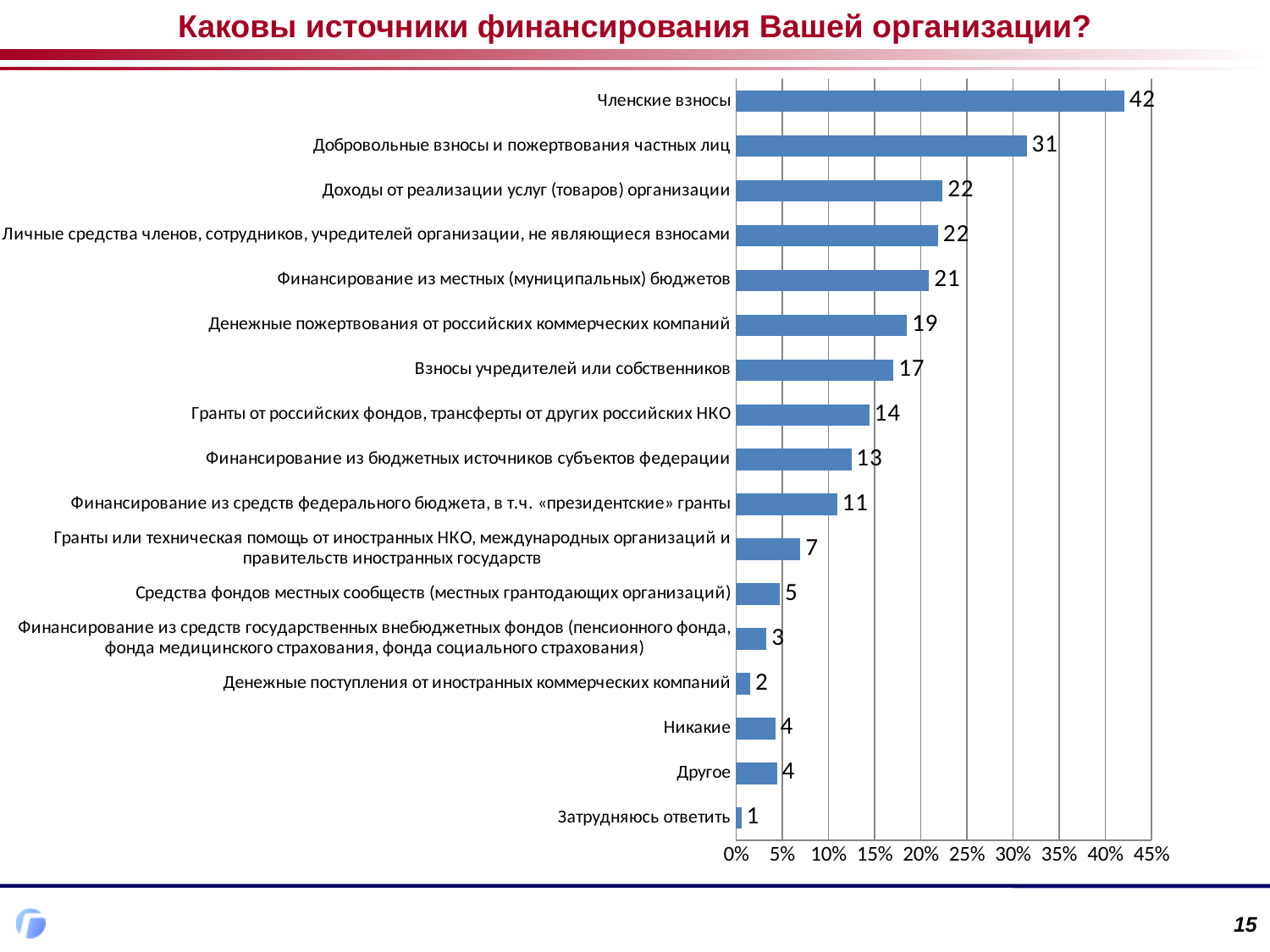
What is the title of the slide? Каковы источники финансирования Вашей организации? What is the value for Добровольные взносы и пожертвования частных лиц? 31 What is the value for Финансирование из местных (муниципальных) бюджетов? 21 Which category has the lowest value? Затрудняюсь ответить Which is larger: the value for Взносы учредителей или собственников or the value for Гранты от российских фондов, трансферты от других российских НКО? Взносы учредителей или собственников What is the value for Членские взносы? 42 What is the difference between the values for Членские взносы and Добровольные взносы и пожертвования частных лиц? 11 How many categories are shown in the chart? 17 Is the value for Членские взносы greater or less than 40%? greater What is the value for Денежные поступления от иностранных коммерческих компаний? 2 Which category has the highest value? Членские взносы What kind of chart is shown on the slide? bar chart